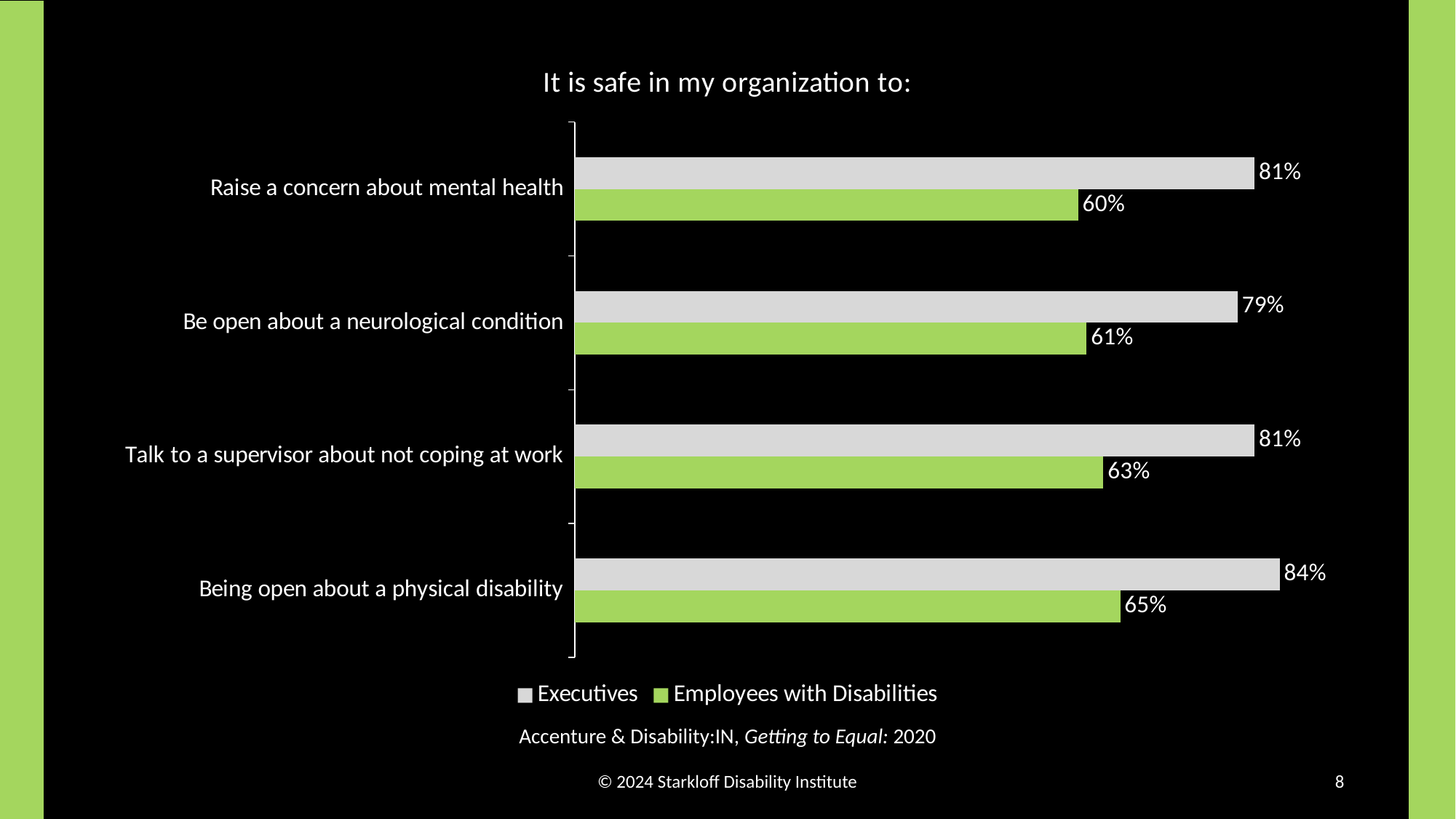
What percentage of Executives say it is safe to be open about a physical disability? 84% How many series does the legend list? 2 What is the difference between the Executives and Employees with Disabilities values for being open about a physical disability? 19 percentage points How many categories are shown on the chart? 4 Which is larger: the Executives value for being open about a neurological condition or the Executives value for being open about a physical disability? Being open about a physical disability For which category is the Executives value highest? Being open about a physical disability What percentage of Executives say it is safe to raise a concern about mental health? 81% What percentage of Employees with Disabilities say it is safe to be open about a neurological condition? 61% What kind of chart is shown on the slide? Bar chart What percentage of Employees with Disabilities say it is safe to talk to a supervisor about not coping at work? 63% For which category is the Employees with Disabilities value lowest? Raise a concern about mental health What is the difference between the Executives and Employees with Disabilities values for raising a concern about mental health? 21 percentage points